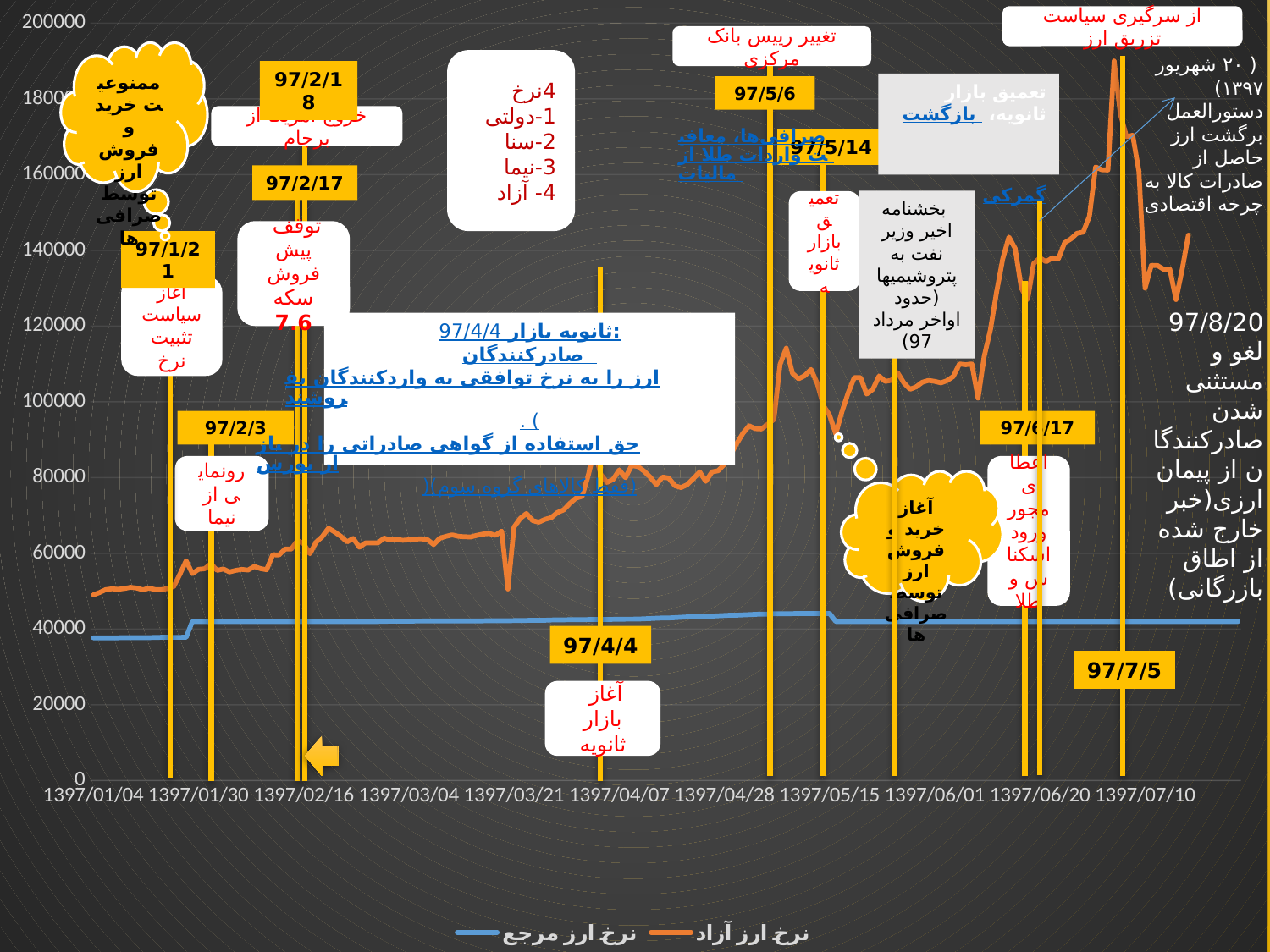
Is the peak value of نرخ ارز آزاد greater or less than 160000? greater What is the first date label on the x axis? 1397/01/04 How many series does the legend list? 2 What kind of chart is shown on the slide? line chart At 1397/04/07, which series has the higher value, نرخ ارز آزاد or نرخ ارز مرجع? نرخ ارز آزاد Does نرخ ارز آزاد generally rise or fall from 1397/01/04 to 1397/07/10? rise What are the two series named in the legend? نرخ ارز آزاد and نرخ ارز مرجع Is the value of نرخ ارز آزاد at 1397/01/04 greater or less than 60000? less Is the value of نرخ ارز آزاد at 1397/05/15 greater or less than 80000? greater Which series reaches the highest value on the chart? نرخ ارز آزاد